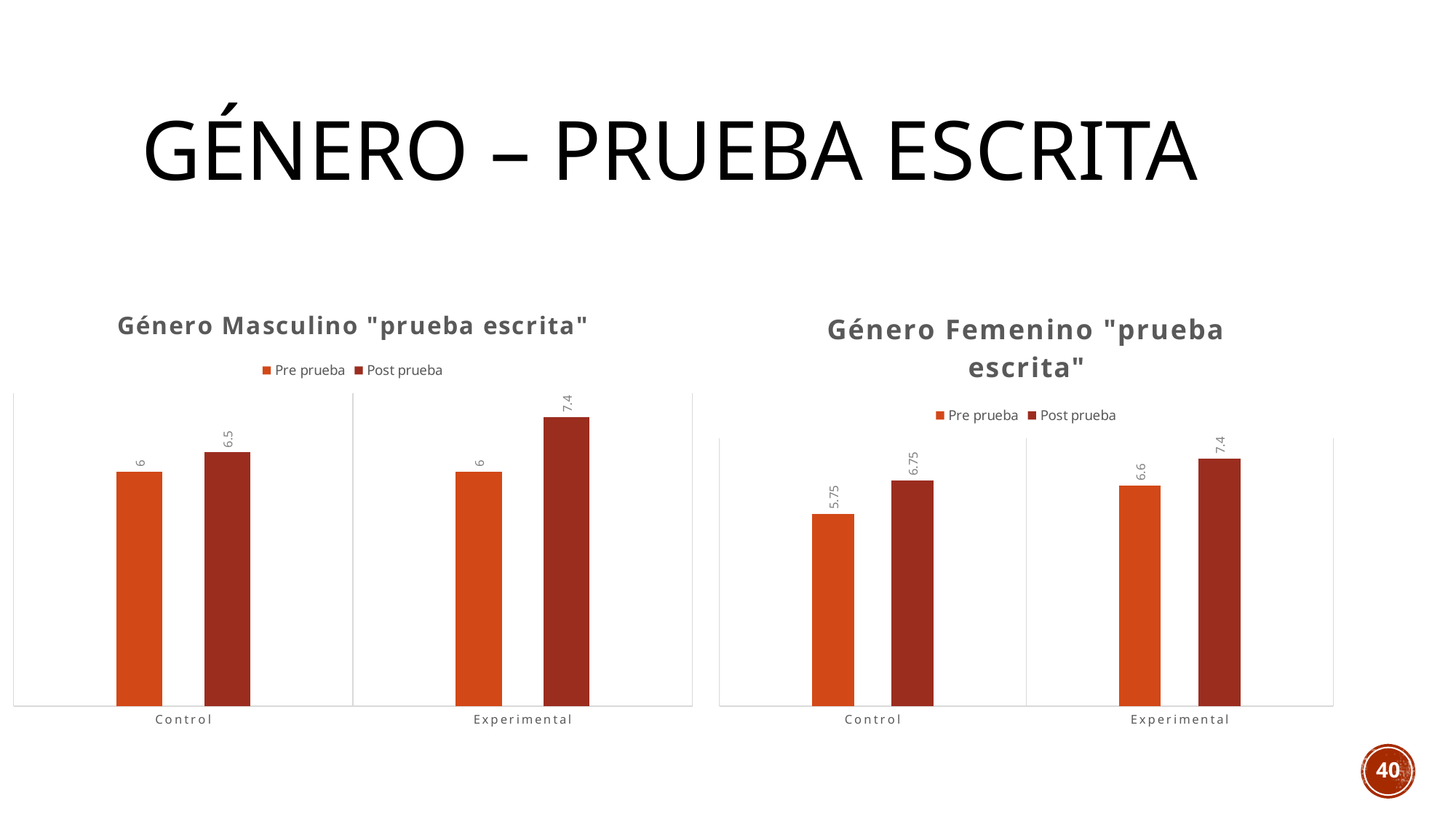
How many categories are shown on the x axis of the chart titled Género Femenino "prueba escrita"? 2 In the chart titled Género Femenino "prueba escrita", what is the Pre prueba value for Control? 5.75 In the chart titled Género Femenino "prueba escrita", which group has the higher Pre prueba value, Control or Experimental? Experimental How many series does the legend list in the chart titled Género Masculino "prueba escrita"? 2 In the chart titled Género Masculino "prueba escrita", what is the Pre prueba value for Control? 6 In the chart titled Género Masculino "prueba escrita", what is the Post prueba value for Experimental? 7.4 In the chart titled Género Femenino "prueba escrita", what is the Post prueba value for Control? 6.75 In the chart titled Género Masculino "prueba escrita", what is the difference between the Post prueba and Pre prueba values for Experimental? 1.4 In the chart titled Género Femenino "prueba escrita", which bar has the lowest value? Pre prueba for Control In the chart titled Género Femenino "prueba escrita", what is the difference between the Post prueba and Pre prueba values for Control? 1 What kind of chart is the chart titled Género Femenino "prueba escrita"? Bar chart In the chart titled Género Masculino "prueba escrita", which bar has the highest value? Post prueba for Experimental